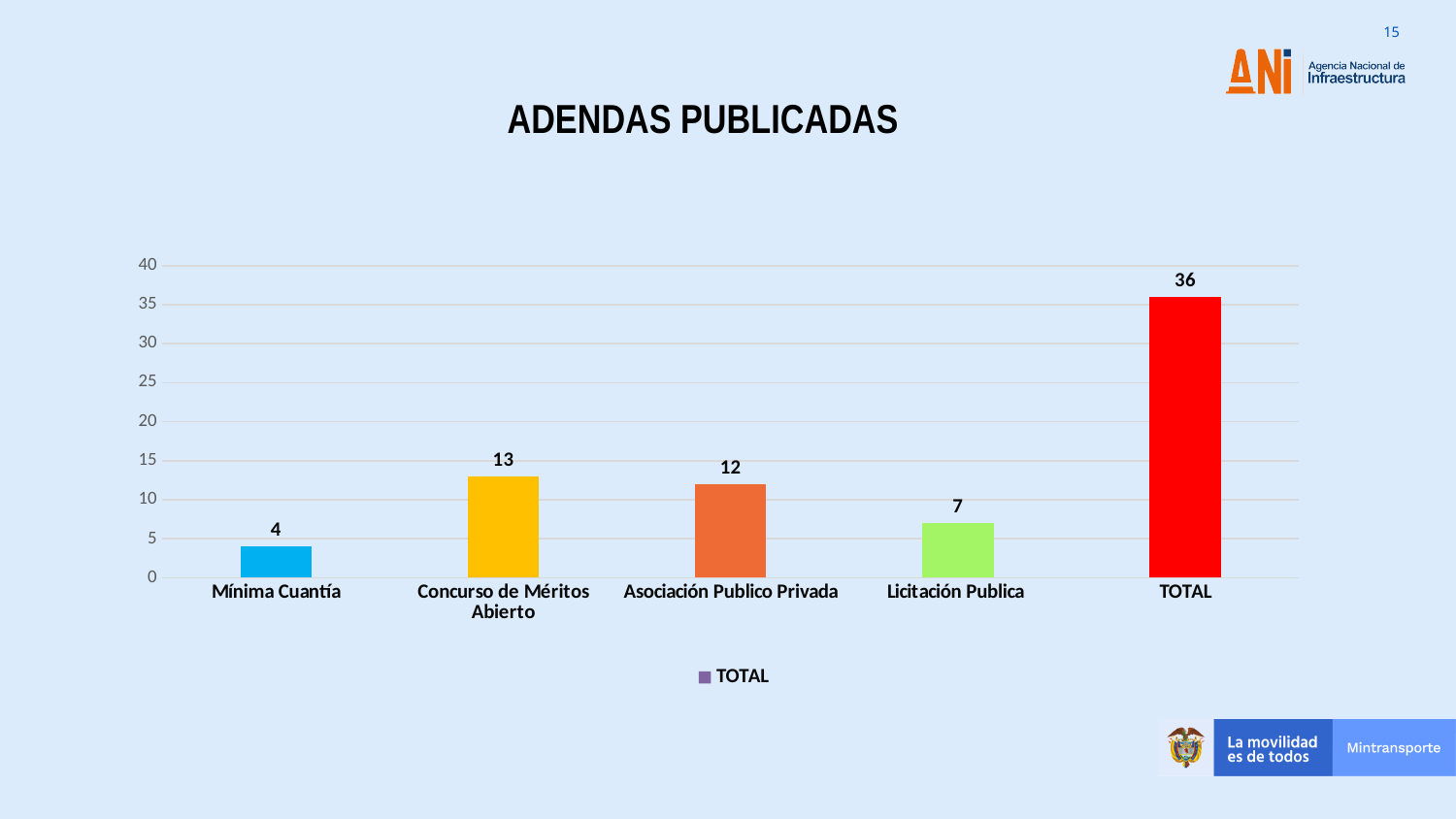
How many bars are plotted in the chart? 5 What is the value for Asociación Publico Privada? 12 What is the value shown for the TOTAL bar? 36 What is the value for Mínima Cuantía? 4 Which category has the lowest value? Mínima Cuantía Excluding the TOTAL bar, which category has the highest value? Concurso de Méritos Abierto What is the title of the chart? ADENDAS PUBLICADAS What is the difference between the values for Concurso de Méritos Abierto and Licitación Publica? 6 What kind of chart is shown on the slide? Bar chart What is the value for Licitación Publica? 7 What is the value for Concurso de Méritos Abierto? 13 Which is larger, the value for Asociación Publico Privada or the value for Mínima Cuantía? Asociación Publico Privada